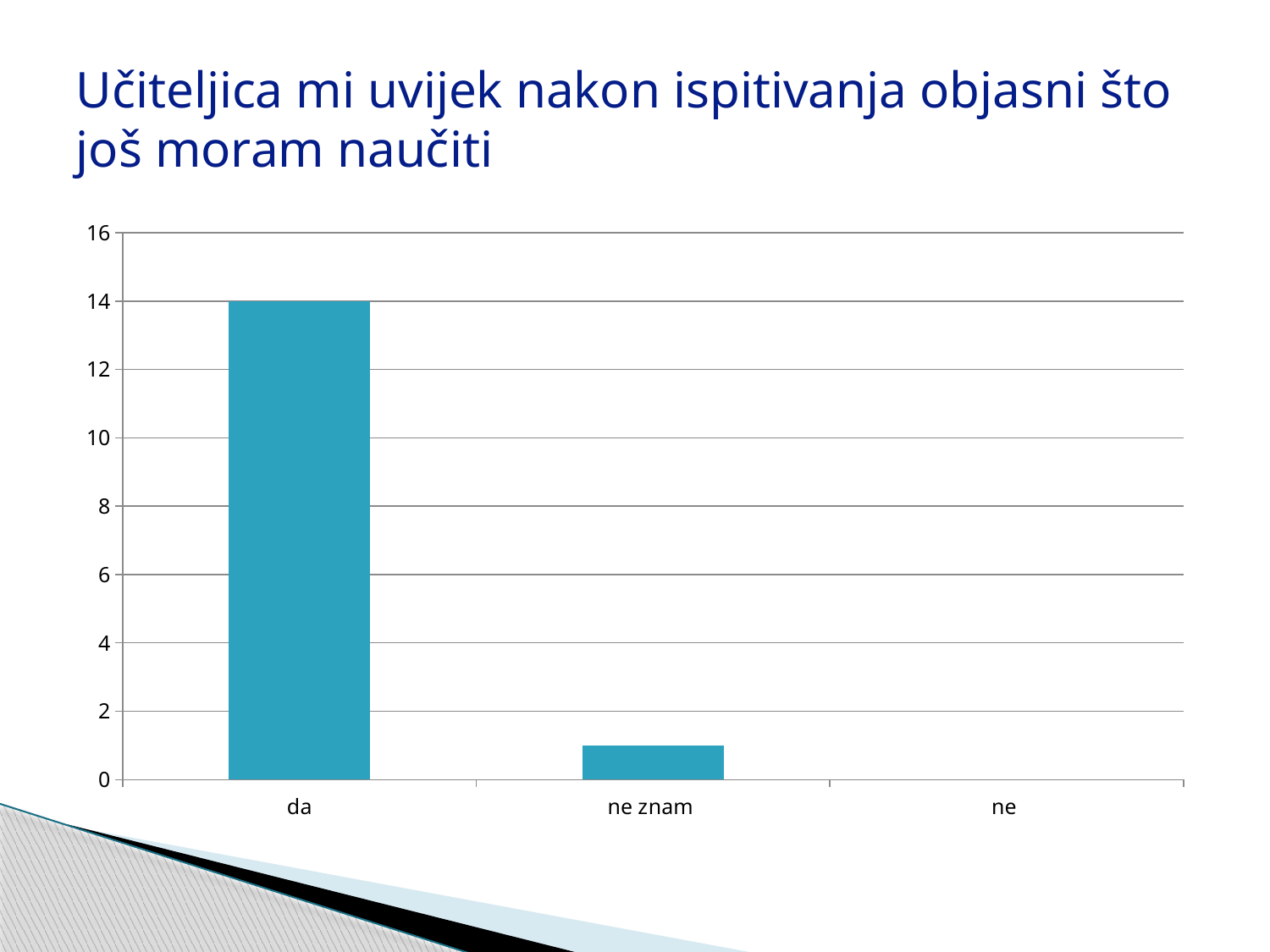
What is the maximum value shown on the vertical axis? 16 Is the value for "ne znam" greater or less than 2? less Which category has the highest value? da Is the value for "ne" greater or less than 2? less What kind of chart is shown on the slide? bar chart Is the value for "da" greater or less than 10? greater Do the values rise or fall from left to right along the x axis? fall What is the value for "da"? 14 How many categories are shown on the x axis? 3 Which category has the lowest value? ne What is the title of the slide containing the chart? Učiteljica mi uvijek nakon ispitivanja objasni što još moram naučiti Which is larger, the value for "da" or the value for "ne znam"? da